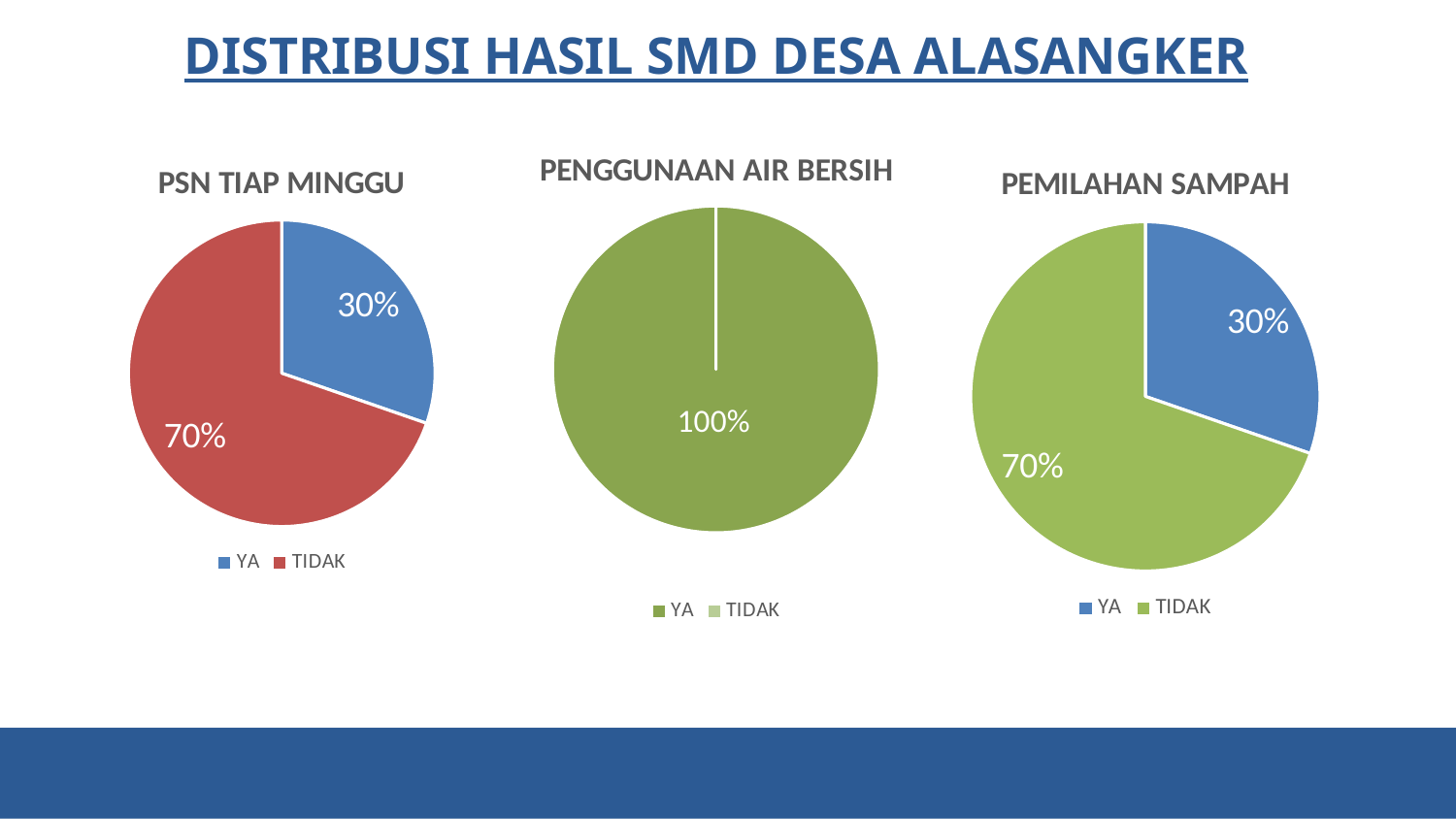
In the 'PSN TIAP MINGGU' chart, what colour is the TIDAK slice? Red In the 'PEMILAHAN SAMPAH' chart, what share of the pie is labelled YA? 30% In the 'PSN TIAP MINGGU' chart, what share of the pie is labelled TIDAK? 70% In the 'PSN TIAP MINGGU' chart, what share of the pie is labelled YA? 30% In the 'PSN TIAP MINGGU' chart, which slice is larger, YA or TIDAK? TIDAK In the 'PSN TIAP MINGGU' chart, what is the difference between the TIDAK and YA shares? 40% What kind of chart is the 'PSN TIAP MINGGU' chart? Pie chart In the 'PEMILAHAN SAMPAH' chart, which slice is the largest? TIDAK In the 'PENGGUNAAN AIR BERSIH' chart, how many entries does the legend list? 2 How many charts are shown on the slide? 3